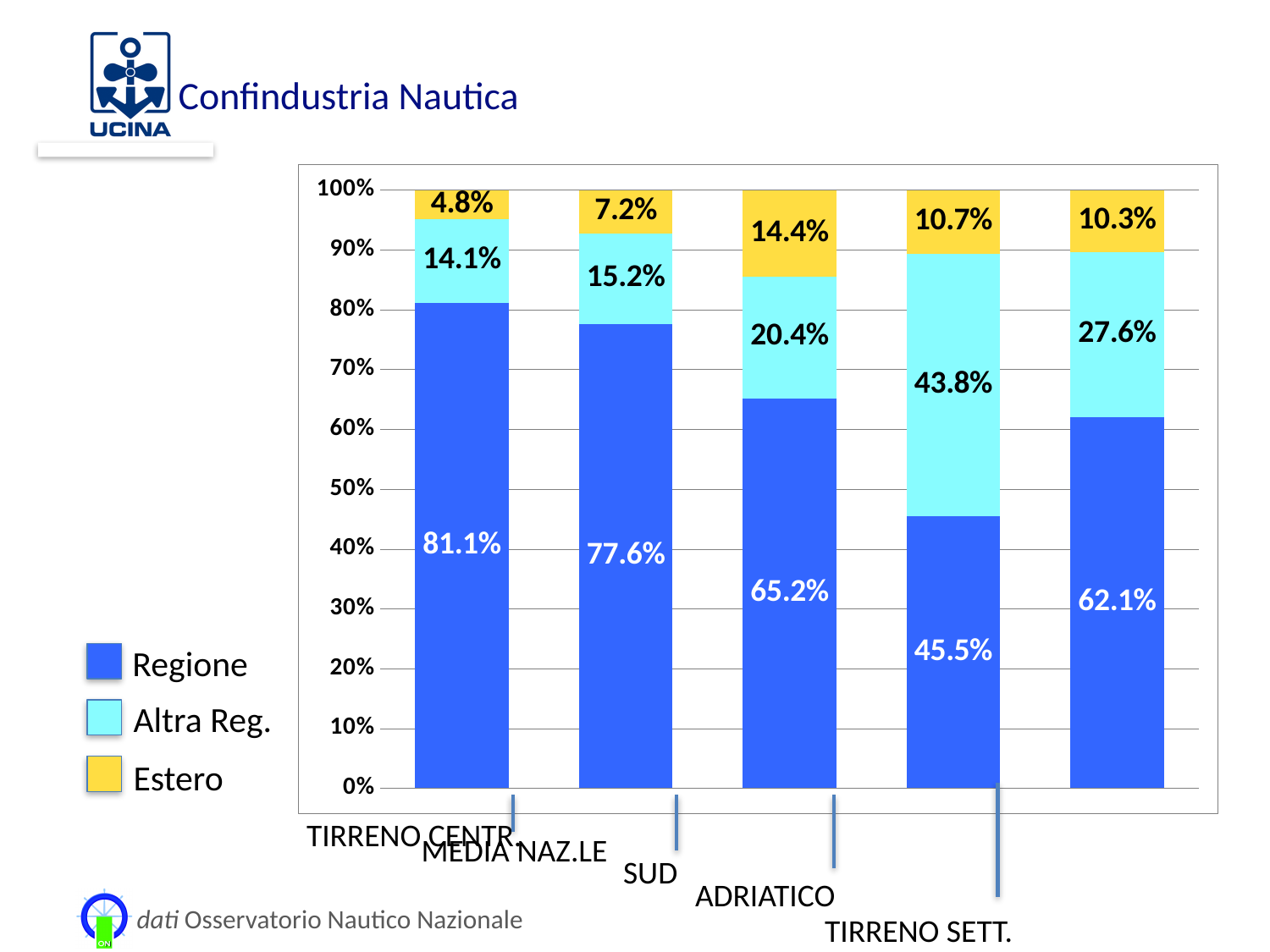
Which category has the highest Regione share? TIRRENO CENTR. How many bars (categories) are plotted in the chart? 5 What kind of chart is shown on the slide? Stacked bar chart Which has the larger Estero share, SUD or TIRRENO SETT.? TIRRENO SETT. Which category has the lowest Estero share? TIRRENO CENTR. What is the Estero share for TIRRENO CENTR.? 4.8% How many series does the legend list? 3 What is the Altra Reg. share for TIRRENO SETT.? 43.8% What is the difference between the Regione share of TIRRENO CENTR. and that of MEDIA NAZ.LE? 19.0 percentage points What is the Regione share for ADRIATICO? 65.2% Which category has the highest Altra Reg. share? TIRRENO SETT. What are the three legend entries of the chart? Regione, Altra Reg., Estero